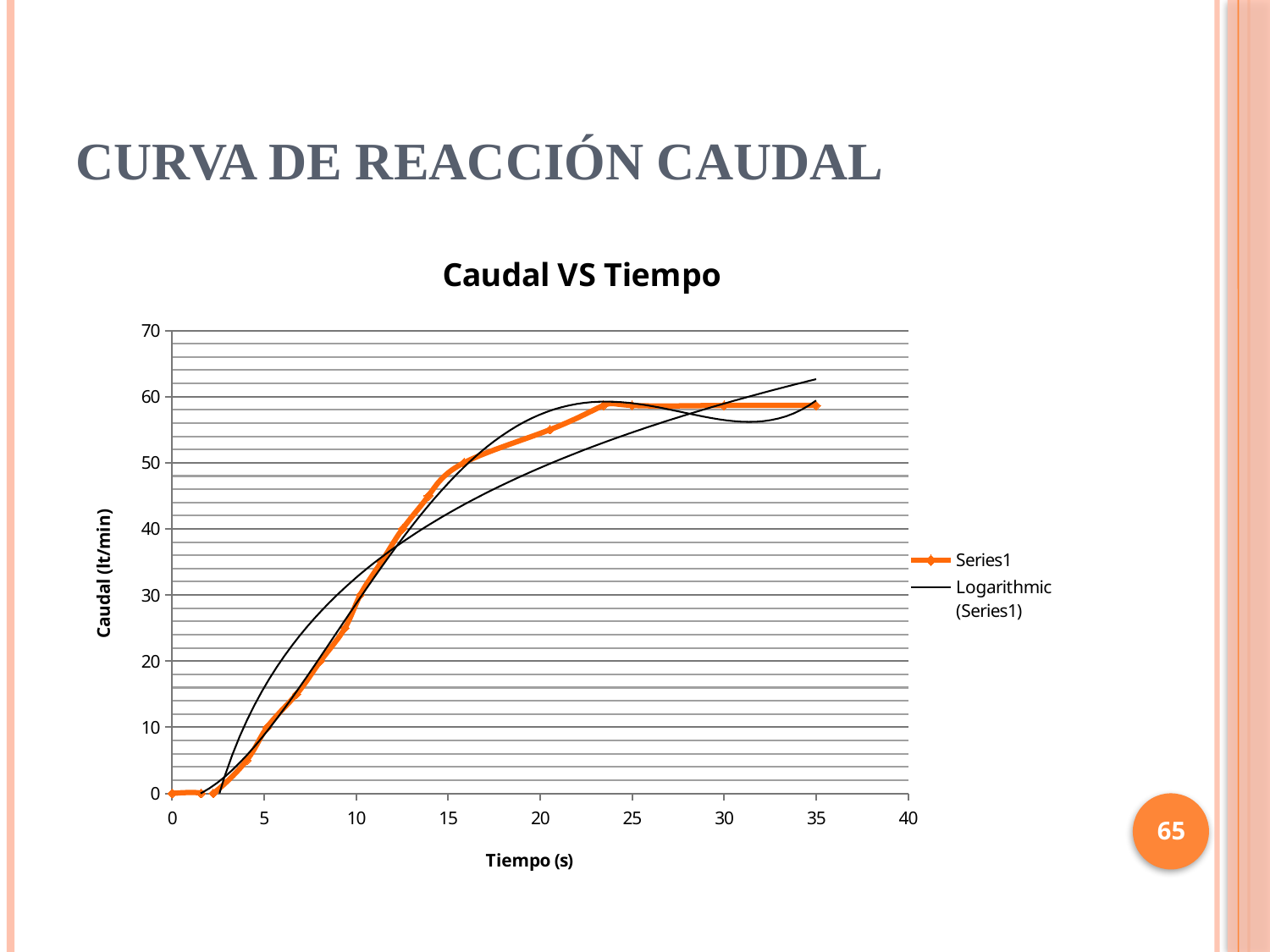
Which is larger, the Series1 value at 10 s or at 25 s? 25 s What kind of chart is shown on the slide? line chart Is the Series1 value at 5 s greater or less than 20? less What is the Series1 value at time 0 s? 0 Is the Series1 value at 35 s greater or less than 50? greater Is the Series1 value at 15 s greater or less than 40? greater Do the Series1 values generally rise or fall as time increases along the x axis? rise How many entries does the chart legend list? 2 What is the title of the chart? Caudal VS Tiempo What is the label of the y axis? Caudal (lt/min)